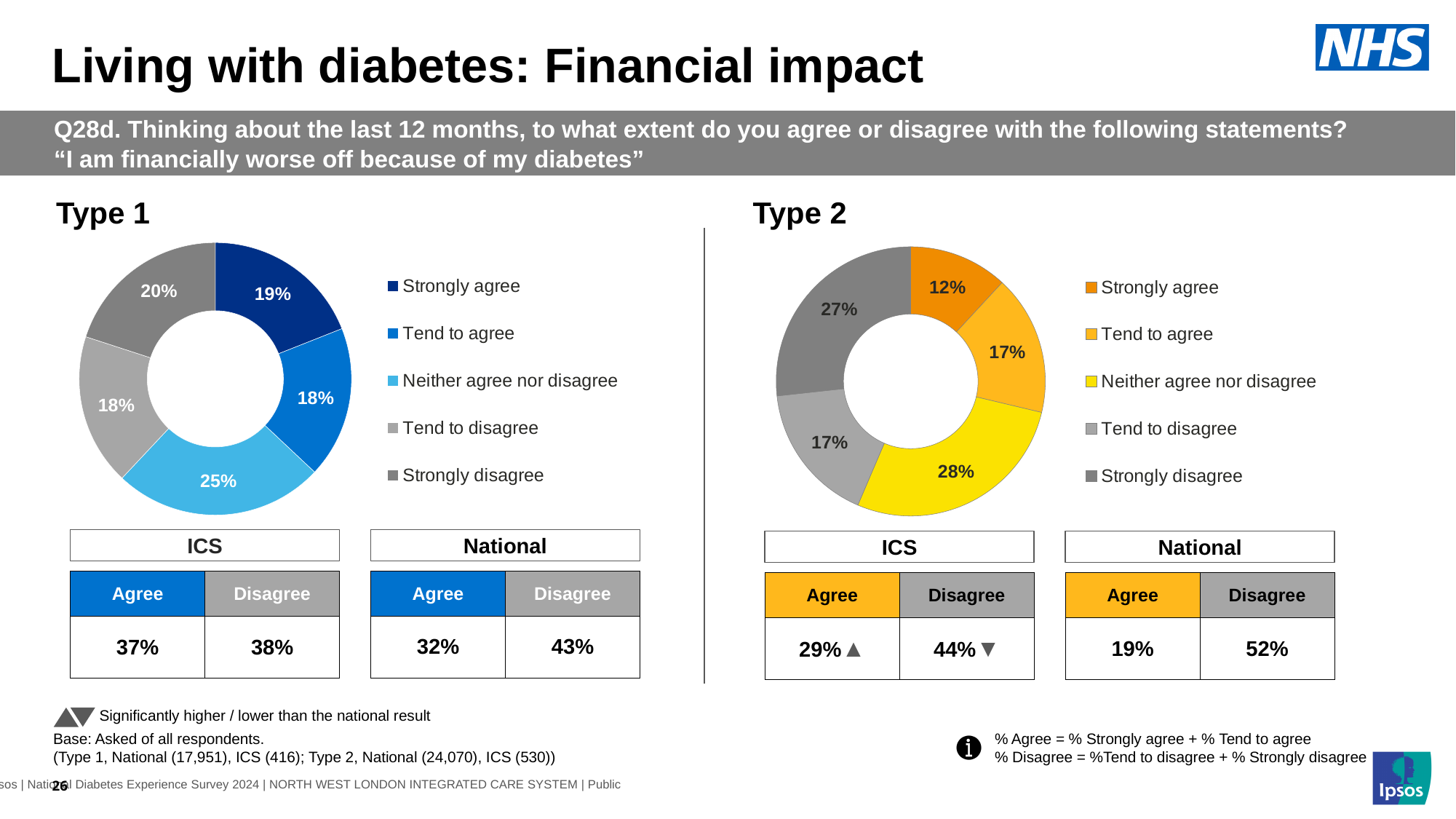
What kind of chart is used for Type 2? Donut (pie) chart In the Type 2 chart, what is the difference in percentage points between 'Neither agree nor disagree' and 'Strongly agree'? 16 percentage points In the Type 1 chart, what percentage of respondents said 'Strongly agree'? 19% In the Type 1 chart, what percentage of respondents said 'Neither agree nor disagree'? 25% In the Type 2 chart, what percentage of respondents said 'Strongly disagree'? 27% In the Type 2 chart, which category has the smallest share? Strongly agree In the Type 1 chart, what is the difference in percentage points between 'Strongly disagree' and 'Strongly agree'? 1 percentage point In the Type 2 chart, what percentage of respondents said 'Strongly agree'? 12% In the Type 1 chart, which category has the largest share? Neither agree nor disagree In the Type 2 chart, which is larger: 'Strongly disagree' or 'Tend to agree'? Strongly disagree In the Type 2 chart, what colour represents 'Neither agree nor disagree'? Yellow How many categories does the Type 1 chart show? 5